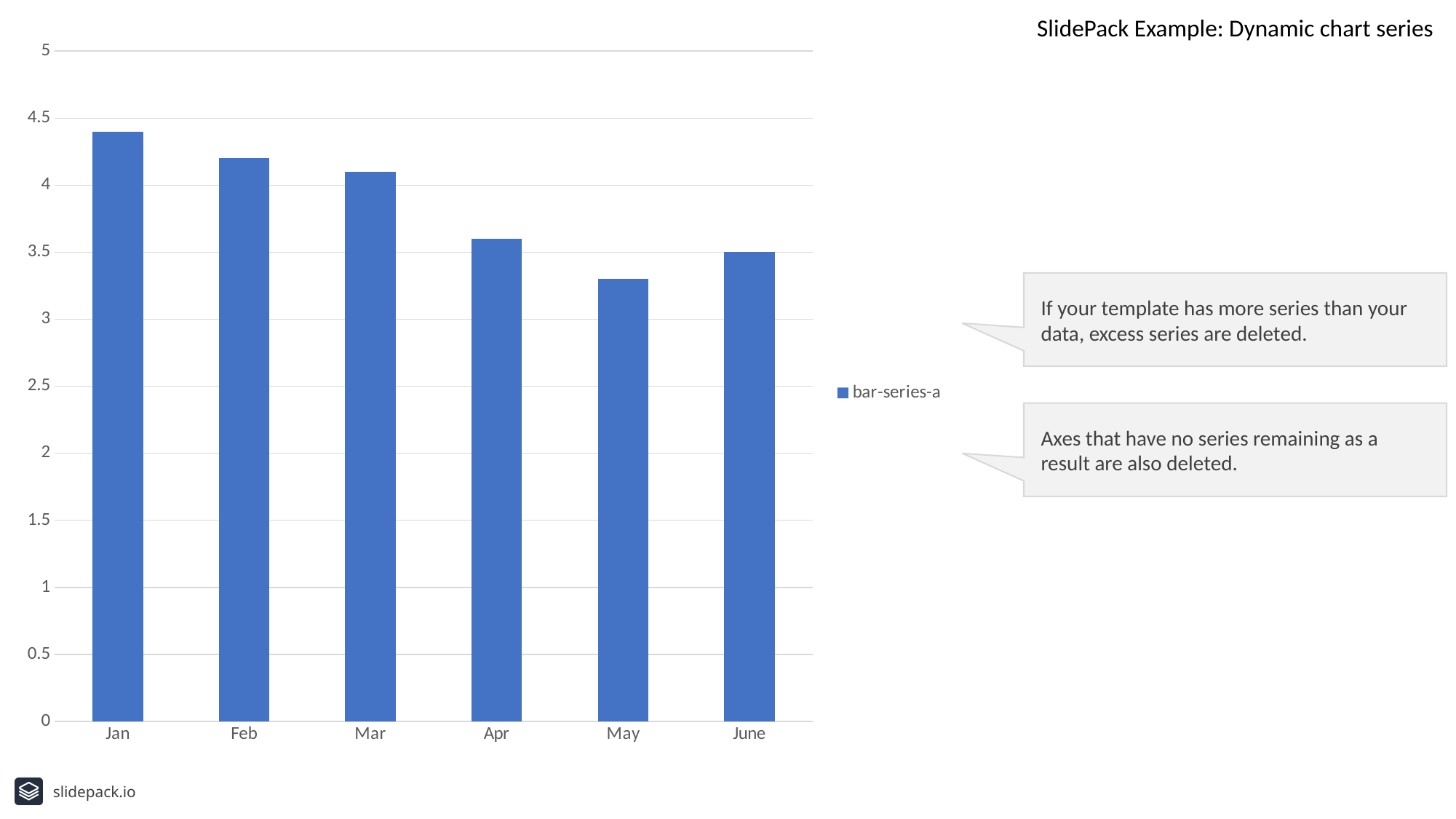
Is the value for Jan greater or less than 4? greater Is the value for May greater or less than 3.5? less Is the value for Apr greater or less than 4? less What is the title shown at the top of the slide? SlidePack Example: Dynamic chart series What is the name of the series shown in the chart's legend? bar-series-a What kind of chart is shown on the slide? bar chart Which is larger, the value for Feb or the value for Apr? Feb Which month has the lowest bar in the chart? May How many series does the chart's legend list? 1 Which month has the highest bar in the chart? Jan Do the bar values generally rise or fall from Jan to June? fall How many categories are shown on the x axis of the chart? 6